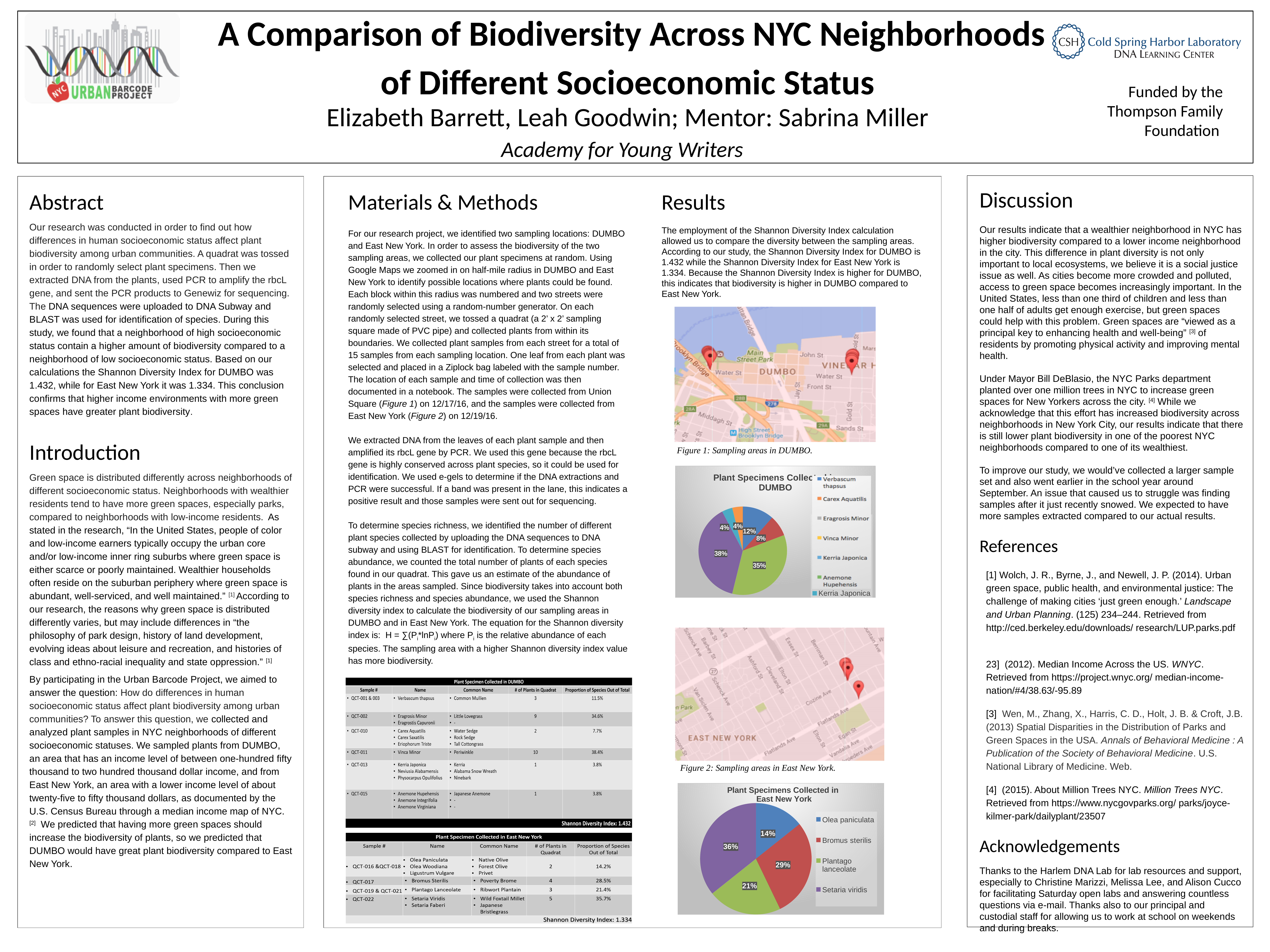
In the 'Plant Specimens Collected in East New York' chart, which species has the largest slice? Setaria viridis In the 'Plant Specimens Collected in East New York' chart, what share does Bromus sterilis have? 29% How many species does the legend of the 'Plant Specimens Collected in East New York' chart list? 4 In the 'Plant Specimens Collected in East New York' chart, what share does Setaria viridis have? 36% In the 'Plant Specimens Collected in East New York' chart, what is the difference between the shares of Setaria viridis and Plantago lanceolate? 15% In the DUMBO pie chart (the upper pie chart), what is the percentage of the smallest slices? 4% In the 'Plant Specimens Collected in East New York' chart, which is larger: Bromus sterilis or Plantago lanceolate? Bromus sterilis What kind of chart is the 'Plant Specimens Collected in East New York' chart? pie chart In the 'Plant Specimens Collected in East New York' chart, which species has the smallest slice? Olea paniculata In the 'Plant Specimens Collected in East New York' chart, what share does Olea paniculata have? 14% How many slices does the DUMBO pie chart (the upper pie chart) have? 6 In the DUMBO pie chart (the upper pie chart), what is the percentage of the largest slice? 38%